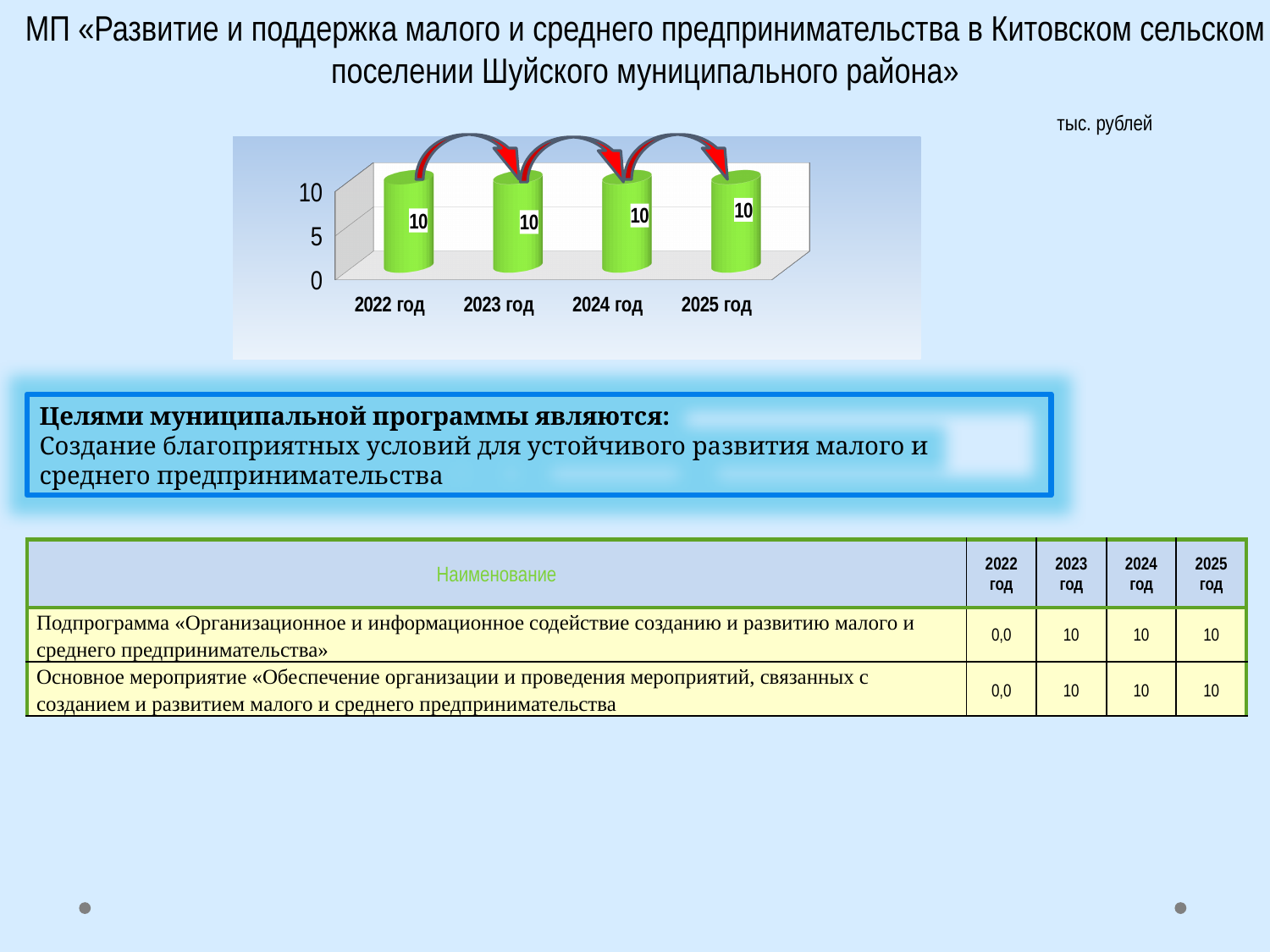
What kind of chart is shown on the slide? bar chart What colour are the bars on the chart? green What is the difference between the values for 2025 год and 2022 год on the chart? 0 What is the value shown for 2025 год on the chart? 10 How many categories (years) are plotted on the chart? 4 What unit is indicated for the chart values? тыс. рублей What is the value shown for 2024 год on the chart? 10 What is the highest tick value shown on the vertical axis of the chart? 10 What is the value shown for 2023 год on the chart? 10 Do the values rise, fall, or stay the same from 2022 год to 2025 год? stay the same Is the value for 2024 год greater or less than 5? greater What is the value shown for 2022 год on the chart? 10